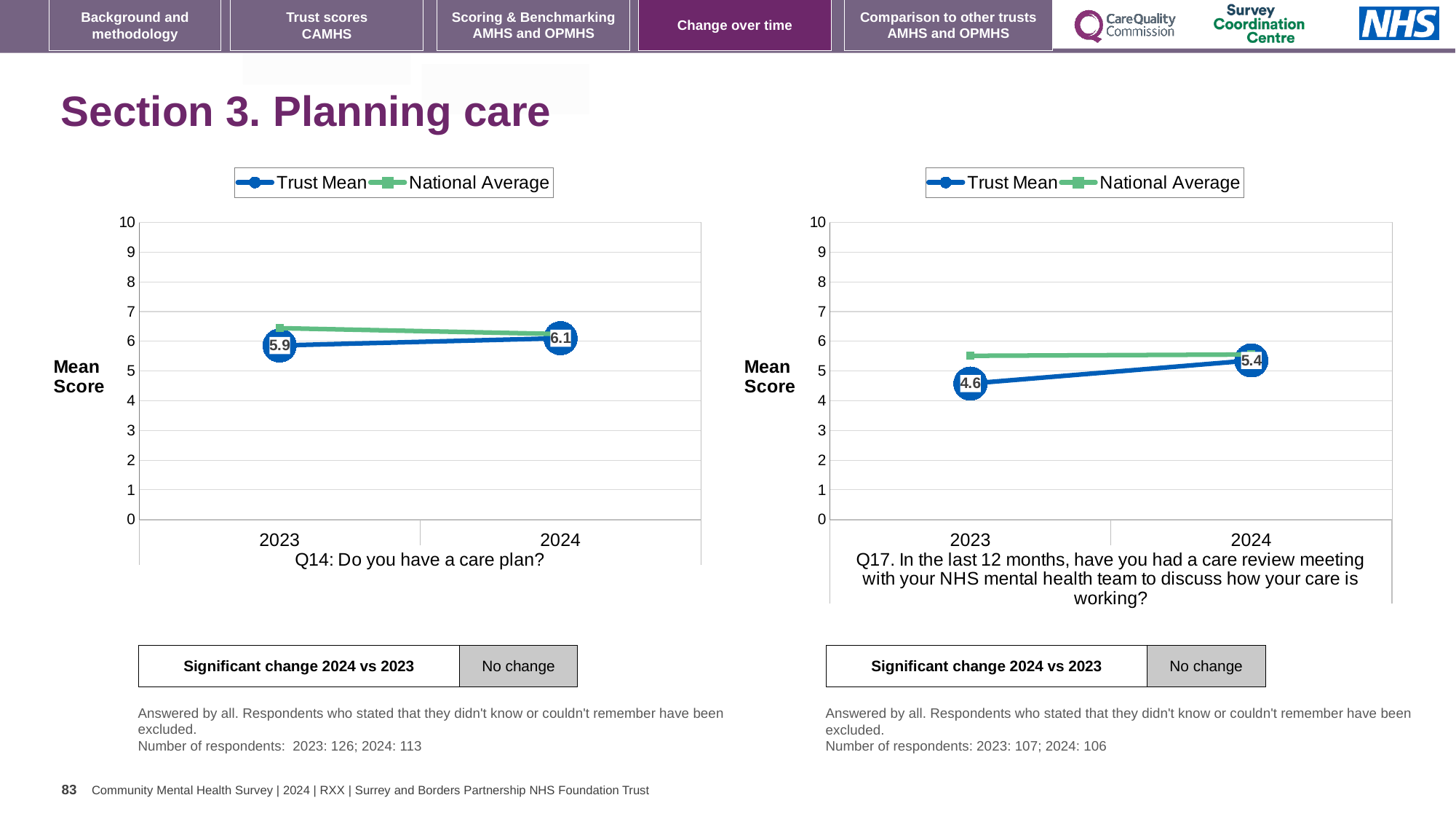
In the Q17 care review meeting chart, is the National Average for 2023 greater or less than 5? greater In the Q14 care plan chart, what is the difference between the Trust Mean in 2024 and 2023? 0.2 In the Q17 care review meeting chart, by how much did the Trust Mean change from 2023 to 2024? 0.8 In the Q17 care review meeting chart, what is the Trust Mean score for 2024? 5.4 In the Q14 care plan chart, is the Trust Mean in 2023 higher or lower than the National Average in 2023? lower In the Q17 care review meeting chart, does the Trust Mean rise or fall from 2023 to 2024? rise What type of chart is the Q14 care plan chart? line chart In the Q14 care plan chart, what is the Trust Mean score for 2023? 5.9 How many years are plotted on the x axis of the Q14 care plan chart? 2 In the Q14 care plan chart, what is the Trust Mean score for 2024? 6.1 In the Q17 care review meeting chart, what is the Trust Mean score for 2023? 4.6 How many series does the legend of the Q17 care review meeting chart list? 2